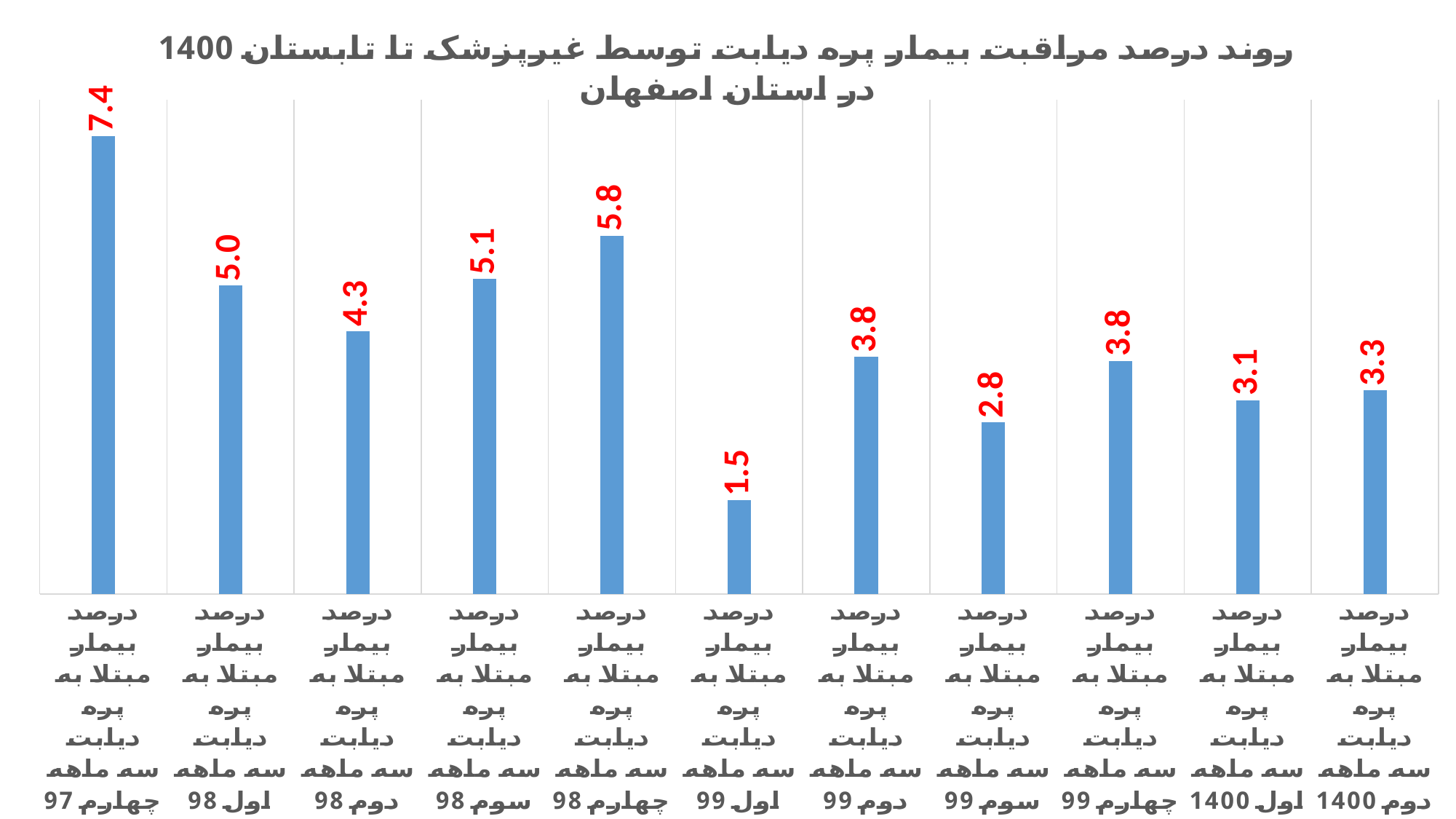
How many bars are shown in the chart? 11 Which is larger, the value for سه ماهه اول 98 or the value for سه ماهه دوم 98? سه ماهه اول 98 Which category has the highest value? سه ماهه چهارم 97 What colour are the bars in the chart? Blue What is the difference between the values for سه ماهه چهارم 97 and سه ماهه اول 99? 5.9 What is the value for سه ماهه اول 99? 1.5 What is the difference between the values for سه ماهه چهارم 98 and سه ماهه سوم 98? 0.7 Which category has the lowest value? سه ماهه اول 99 What is the value for سه ماهه چهارم 97? 7.4 What is the value for سه ماهه دوم 1400? 3.3 What kind of chart is shown on the slide? Bar chart What is the value for سه ماهه چهارم 98? 5.8